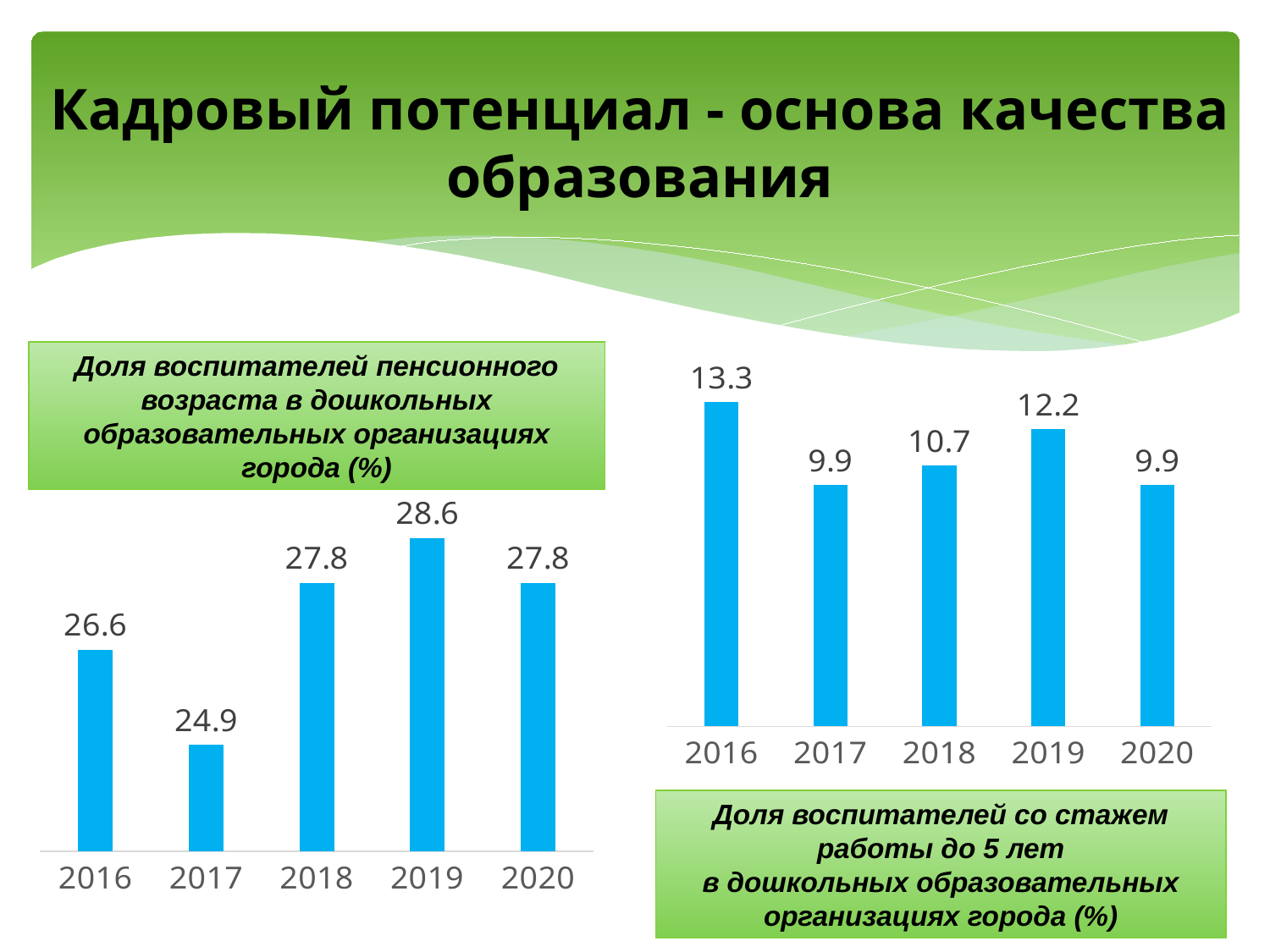
In the left chart (share of pension-age educators), what is the difference between the values for 2019 and 2016? 2.0 What type of chart is the left chart on the slide? bar chart In the left chart (share of pension-age educators), does the value rise or fall from 2016 to 2017? fall In the right chart (share of educators with under 5 years of experience), what is the value for 2018? 10.7 In the right chart (share of educators with under 5 years of experience), which years share the same value of 9.9? 2017 and 2020 In the left chart (share of pension-age educators), which year has the highest value? 2019 In the right chart (share of educators with under 5 years of experience), which year has the highest value? 2016 In the right chart (share of educators with under 5 years of experience), is the value for 2019 larger or smaller than the value for 2018? larger In the left chart (share of pension-age educators), which year has the lowest value? 2017 In the left chart (share of pension-age educators), how many years are shown on the x axis? 5 In the left chart (share of pension-age educators), what is the value for 2017? 24.9 In the right chart (share of educators with under 5 years of experience), what is the difference between the values for 2016 and 2019? 1.1